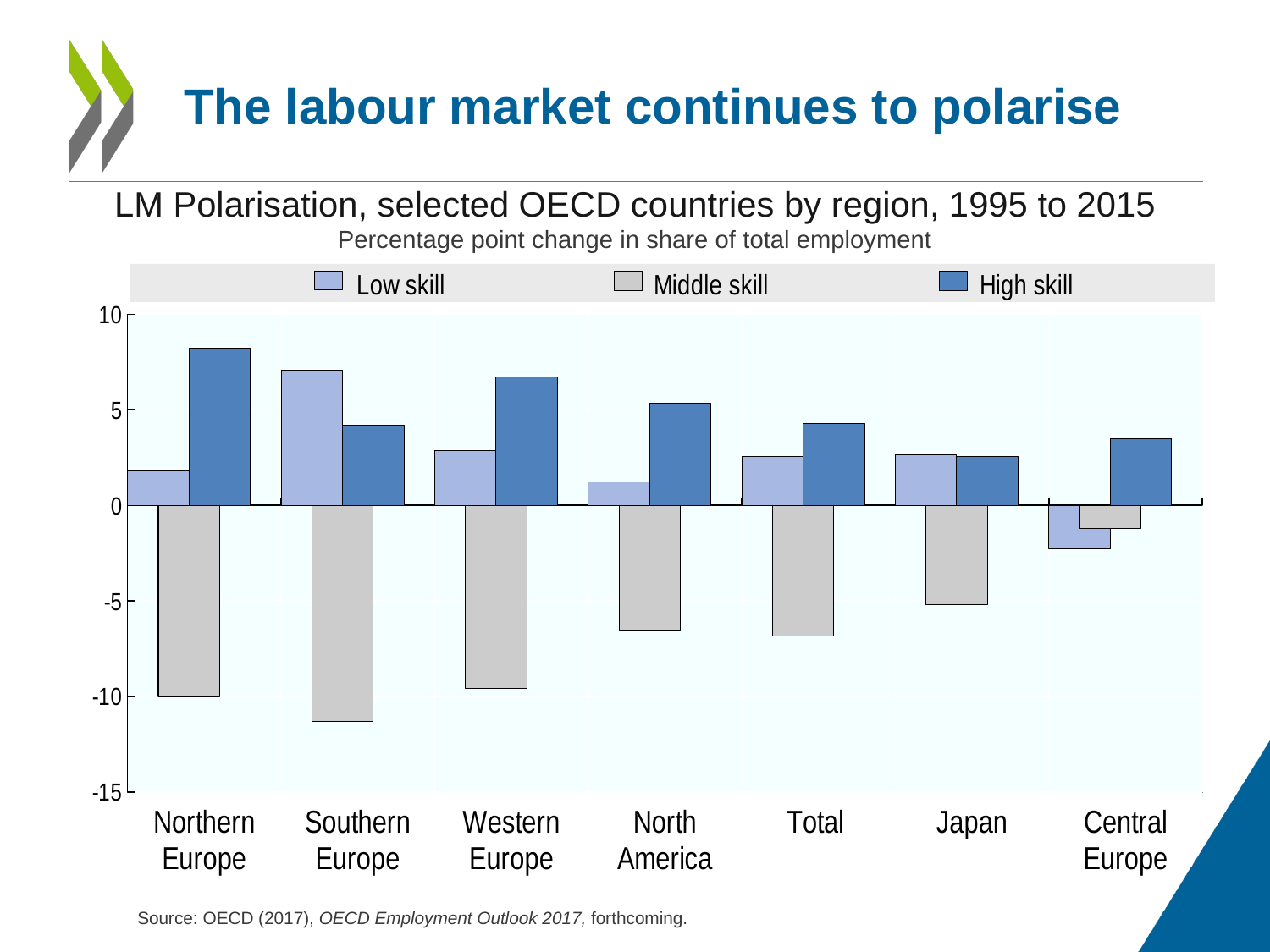
How many regions are shown along the x axis? 7 Which region has the highest Low skill value? Southern Europe Is the Low skill value for Southern Europe greater or less than 5? greater Which is larger, the High skill value for Northern Europe or for Southern Europe? Northern Europe How many series does the legend list? 3 Which region has the lowest (most negative) Middle skill value? Southern Europe Is the Middle skill value for Northern Europe greater or less than -5? less Which region has the highest High skill value? Northern Europe What colour represents the Middle skill series in the legend? Grey Which region is the only one with a negative Low skill value? Central Europe What kind of chart is shown on the slide? Bar chart Is the High skill value for Southern Europe greater or less than 5? less